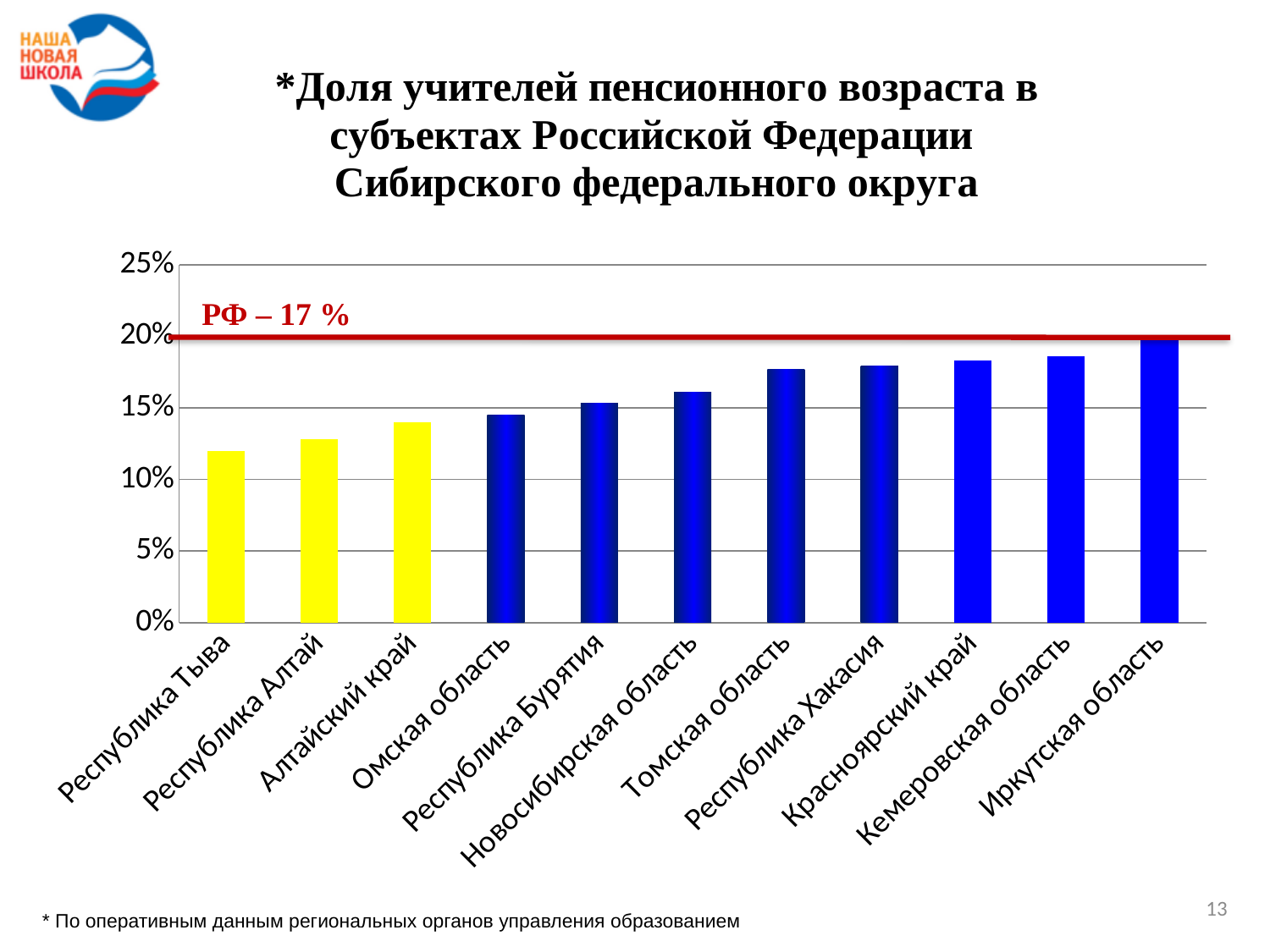
Is the value for Алтайский край greater or less than 15%? less Which is larger, the value for Томская область or the value for Республика Алтай? Томская область What kind of chart is shown on the slide? bar chart What value does the red horizontal line on the chart represent, according to its label? РФ – 17 % Which region has the highest share of teachers of pension age on the chart? Иркутская область Is the value for Томская область greater or less than 15%? greater Which region has the lowest share of teachers of pension age on the chart? Республика Тыва Is the value for Республика Тыва greater or less than 10%? greater How many bars on the chart are coloured yellow? 3 How many regions (categories) are plotted on the chart? 11 Do the bar values rise or fall from left to right along the x axis? rise